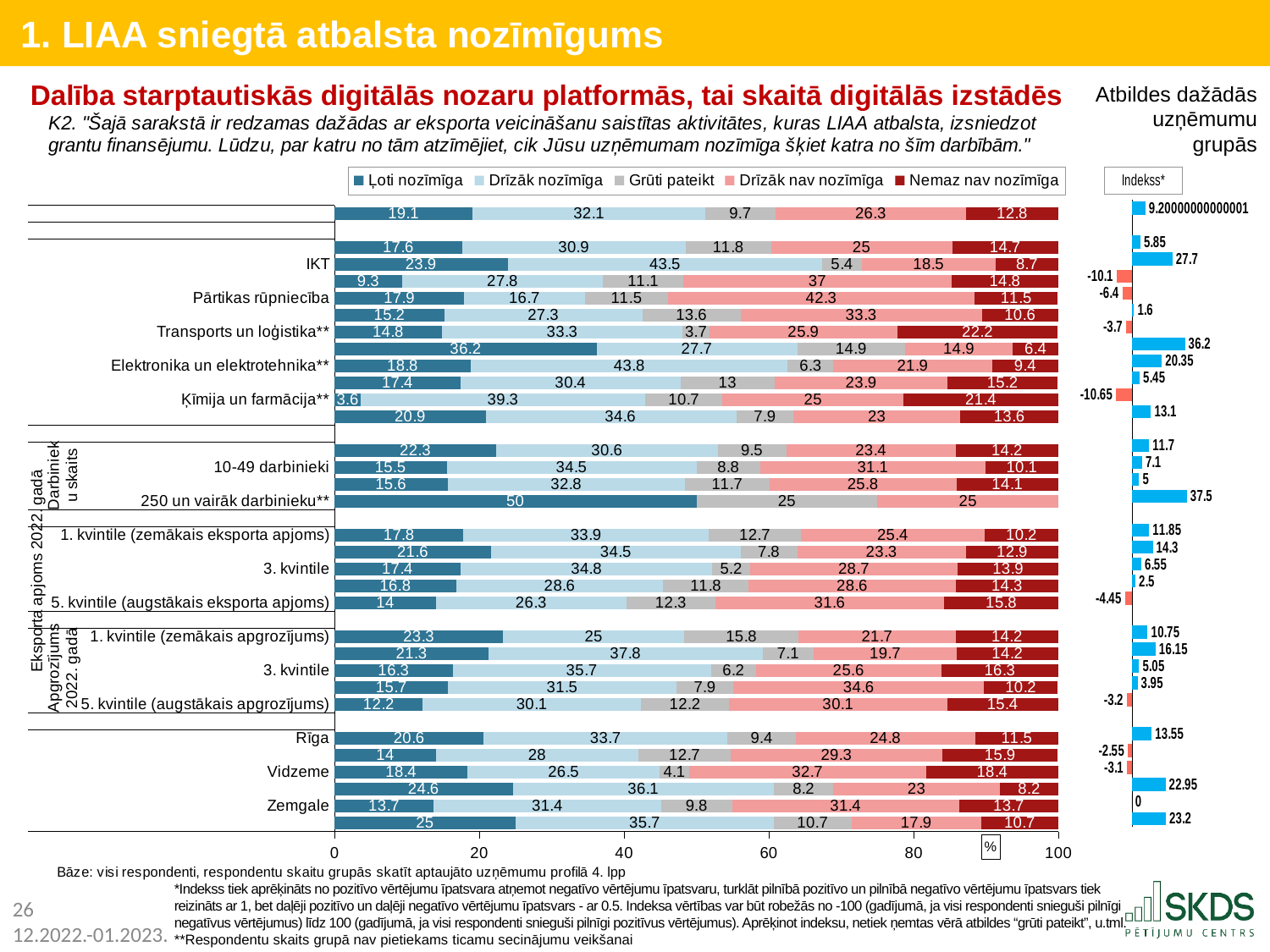
In the stacked bar chart, which has the larger "Ļoti nozīmīga" value: Rīga or Zemgale? Rīga What kind of chart is the main chart on the slide? Stacked bar chart In the stacked bar chart, what is the difference between the "Drīzāk nozīmīga" values for Elektronika un elektrotehnika** and Vidzeme? 17.3 In the stacked bar chart, what is the "Ļoti nozīmīga" value for Ķīmija un farmācija**? 3.6 In the stacked bar chart, what is the "Grūti pateikt" value for Rīga? 9.4 How many series does the legend of the stacked bar chart list? 5 In the stacked bar chart, what is the "Nemaz nav nozīmīga" value for Transports un loģistika**? 22.2 In the stacked bar chart, what is the "Ļoti nozīmīga" value for IKT? 23.9 In the stacked bar chart, what is the "Ļoti nozīmīga" value for 250 un vairāk darbinieku**? 50 In the Indekss* chart on the right, what is the index value for Rīga? 13.55 In the stacked bar chart, what is the "Drīzāk nav nozīmīga" value for Pārtikas rūpniecība? 42.3 In the Indekss* chart on the right, what is the index value for Zemgale? 0